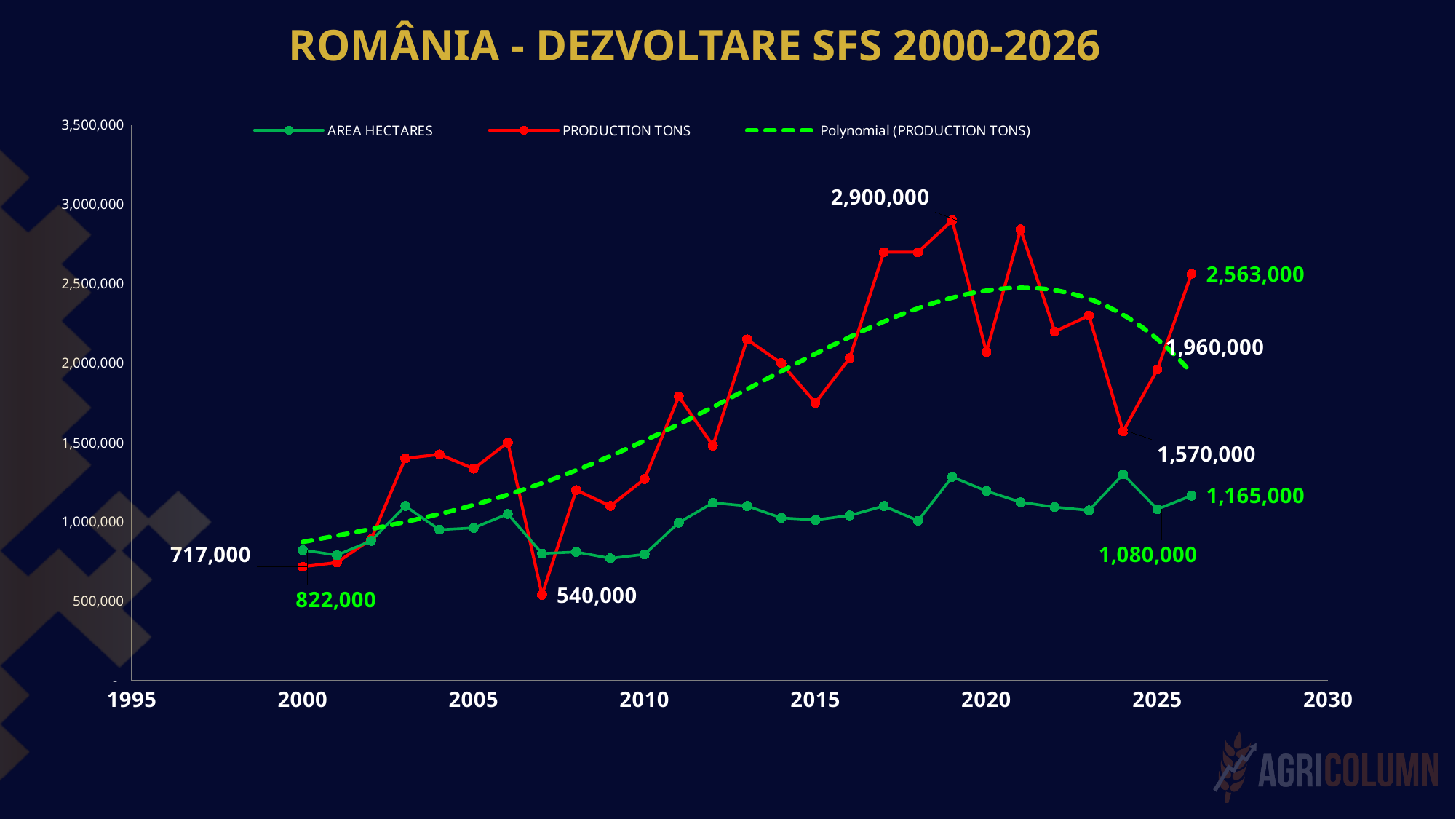
What kind of chart is shown on the slide? line chart By how much does PRODUCTION TONS in 2026 exceed PRODUCTION TONS in 2024? 993,000 What is the difference between AREA HECTARES in 2026 and in 2025? 85,000 In which year is PRODUCTION TONS at its highest? 2019 What is the PRODUCTION TONS value for 2000? 717,000 How many entries does the legend list? 3 What is the AREA HECTARES value for 2026? 1,165,000 In 2000, which series has the larger value, AREA HECTARES or PRODUCTION TONS? AREA HECTARES In which year is PRODUCTION TONS at its lowest? 2007 What is the PRODUCTION TONS value for 2007? 540,000 Is the AREA HECTARES value for 2019 greater or less than 1,000,000? greater What is the PRODUCTION TONS value for 2019? 2,900,000